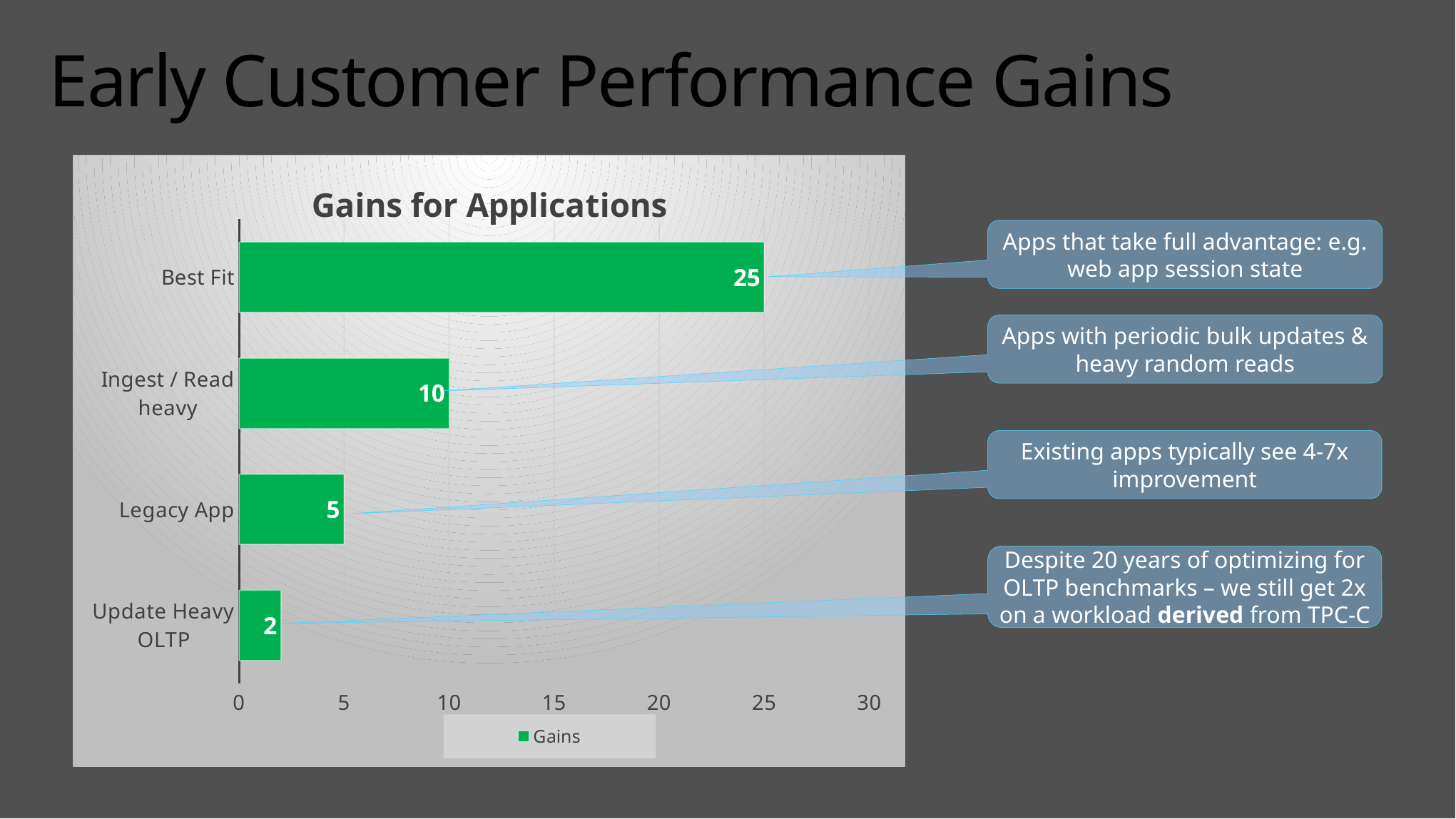
What is the difference between the values for Best Fit and Ingest / Read heavy? 15 What is the value for Legacy App? 5 Which category has the lowest value? Update Heavy OLTP What is the value for Best Fit? 25 What is the value for Ingest / Read heavy? 10 Which is larger, the value for Legacy App or the value for Update Heavy OLTP? Legacy App How many categories are shown in the chart? 4 What is the title of the chart? Gains for Applications What is the value for Update Heavy OLTP? 2 Which category has the highest value? Best Fit What kind of chart is shown? bar chart Is the value for Best Fit greater or less than 20? greater